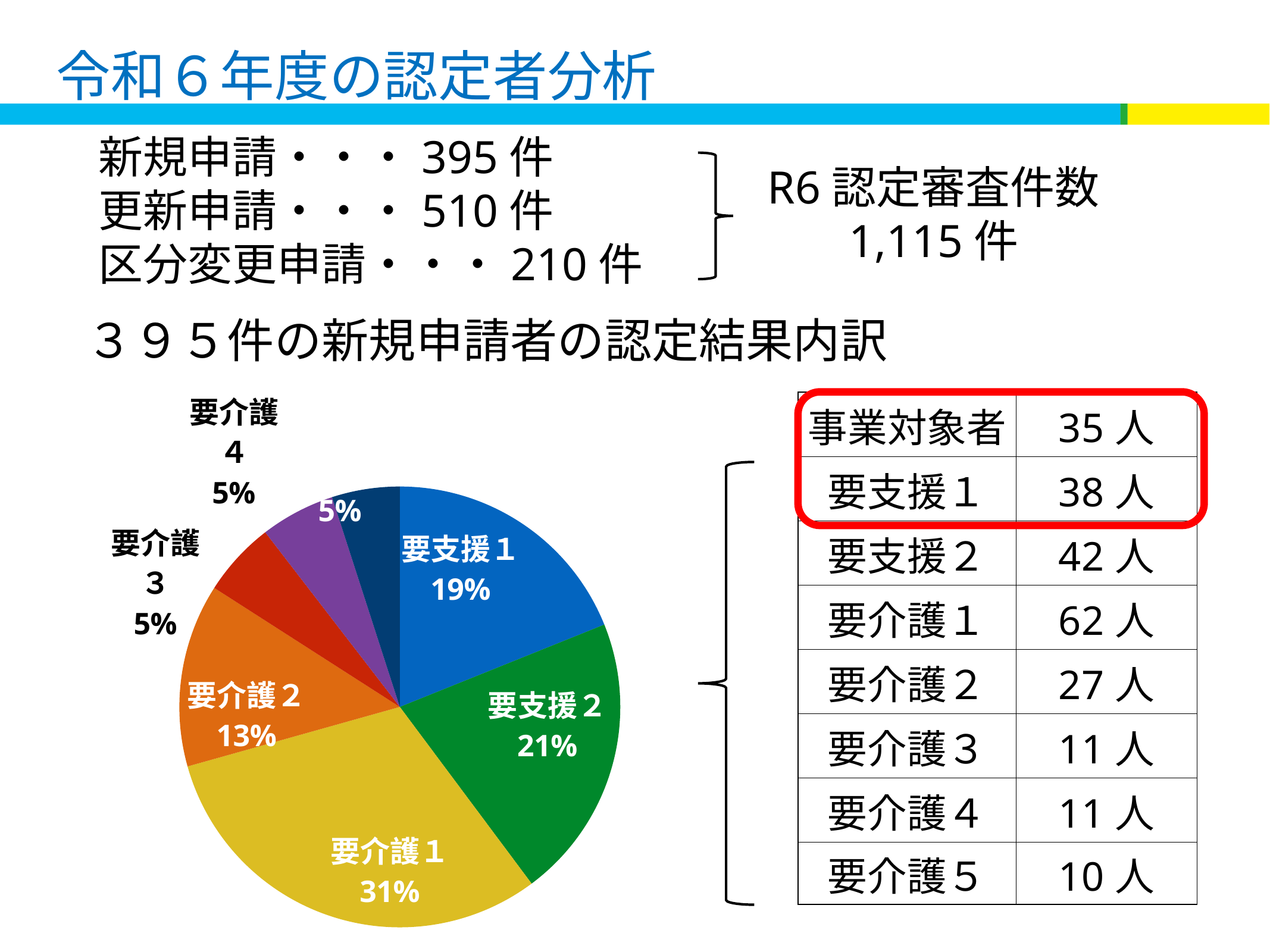
How many slices does the pie chart have? 7 What share of the pie chart does 要支援2 represent? 21% What share of the pie chart does 要介護3 represent? 5% What colour is the 要介護1 slice in the pie chart? yellow Which category has the largest slice in the pie chart? 要介護1 What share of the pie chart does 要介護2 represent? 13% What is the difference in percentage points between 要介護1 and 要介護2 in the pie chart? 18 Which is larger in the pie chart, 要支援1 or 要支援2? 要支援2 What kind of chart is shown on the slide? pie chart